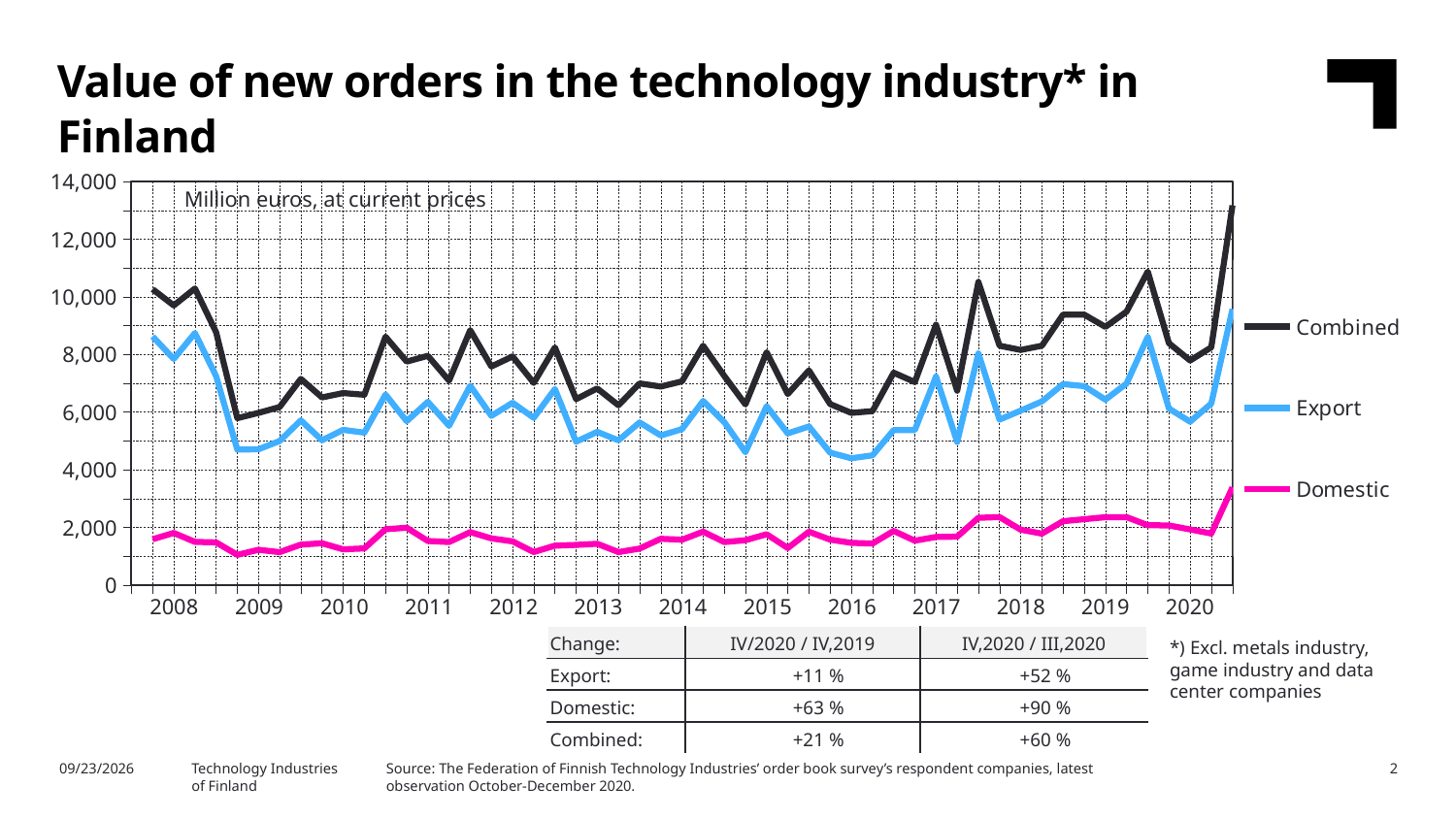
Which series is plotted in pink? Domestic Which is larger at the end of 2020, the Export value or the Domestic value? Export How many years are labelled on the x axis? 13 Which series has the lowest values throughout the chart? Domestic Is the value for Combined at the last point in 2020 greater or less than 12,000? greater According to the table below the chart, what is the Domestic change for IV,2020 / III,2020? +90 % Which series has the highest values throughout the chart? Combined How many series does the legend list? 3 Is the value for Domestic at the last point in 2020 greater or less than 4,000? less Is the value for Export at the last point in 2020 greater or less than 8,000? greater What kind of chart is shown on the slide? line chart What unit is stated in the label inside the chart area? Million euros, at current prices